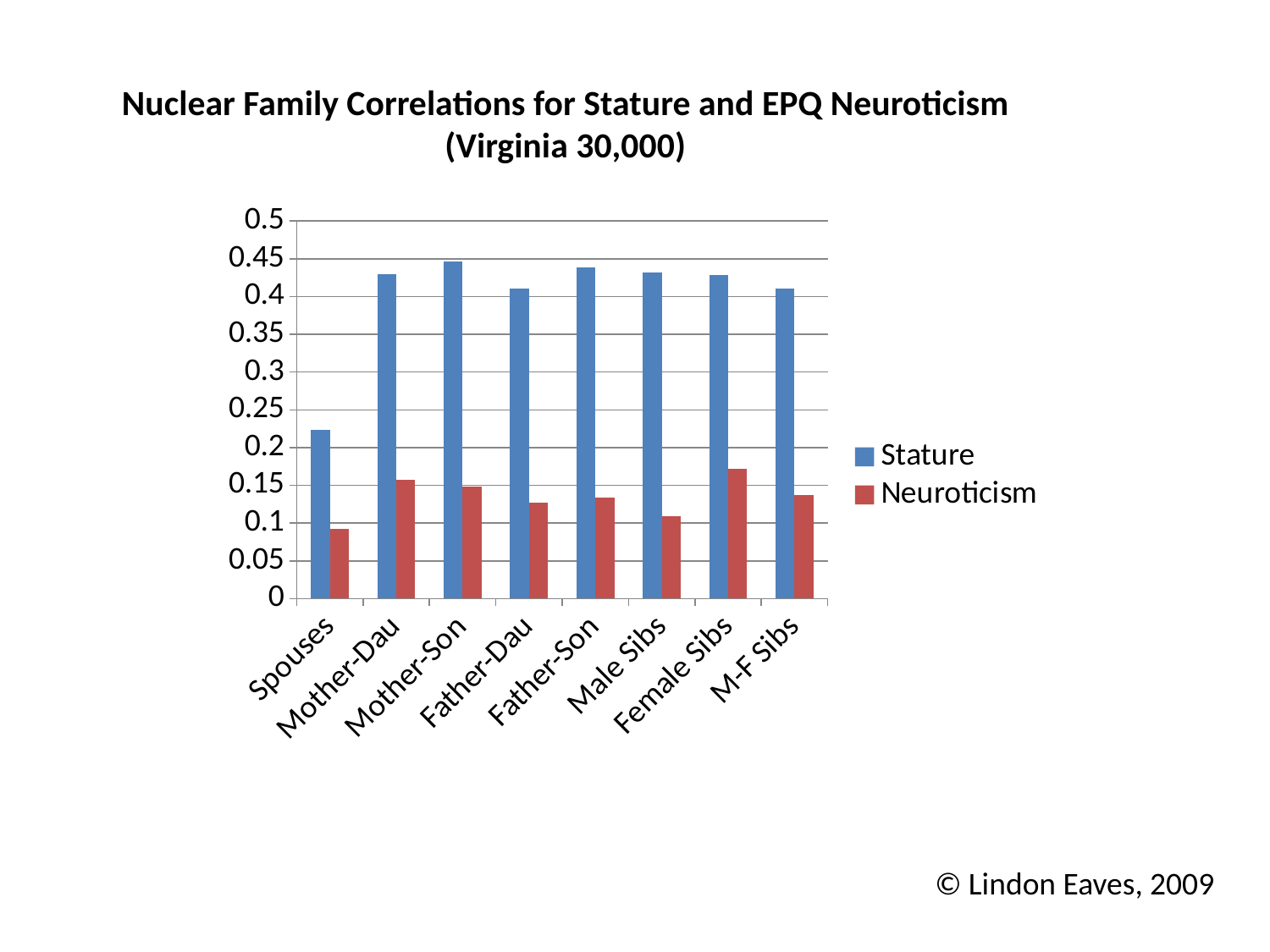
Which category has the lowest Neuroticism correlation? Spouses Which category has the highest Neuroticism correlation? Female Sibs For Spouses, which series has the larger value, Stature or Neuroticism? Stature Which category has the lowest Stature correlation? Spouses What kind of chart is shown on the slide? bar chart How many series does the legend list? 2 Is the Neuroticism value for Spouses greater or less than 0.1? less Which colour represents the Neuroticism series? red Is the Neuroticism value for Female Sibs greater or less than 0.15? greater How many family relationship categories are shown on the x axis? 8 Is the Stature value for Spouses greater or less than 0.2? greater